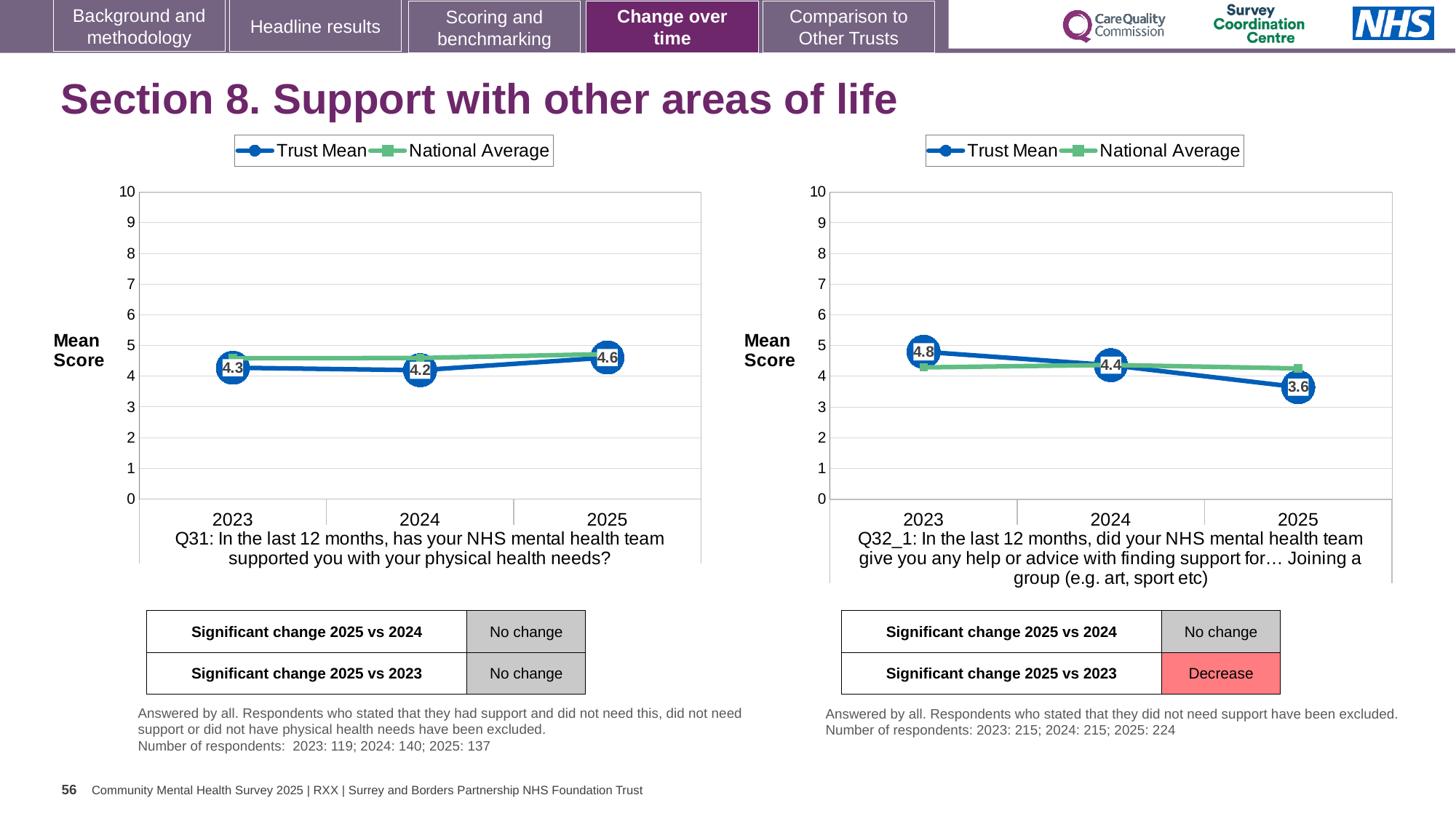
In the Q32_1 chart on the right, what is the difference between the Trust Mean for 2023 and 2025? 1.2 In the Q32_1 chart on the right, which year has the lowest Trust Mean? 2025 In the Q32_1 chart on the right, what is the Trust Mean for 2023? 4.8 In the Q31 chart on the left, what is the Trust Mean for 2025? 4.6 In the Q31 chart on the left, what is the Trust Mean for 2024? 4.2 What kind of chart is the Q32_1 chart on the right? Line chart In the Q32_1 chart on the right, is the National Average for 2025 greater or less than 5? less In the Q32_1 chart on the right, what is the Trust Mean for 2025? 3.6 In the Q31 chart on the left, is the Trust Mean higher in 2023 or 2024? 2023 In the Q31 chart on the left, which year has the highest Trust Mean? 2025 How many years are plotted on the x axis of the Q31 chart on the left? 3 How many series does the legend of the Q32_1 chart on the right list? 2